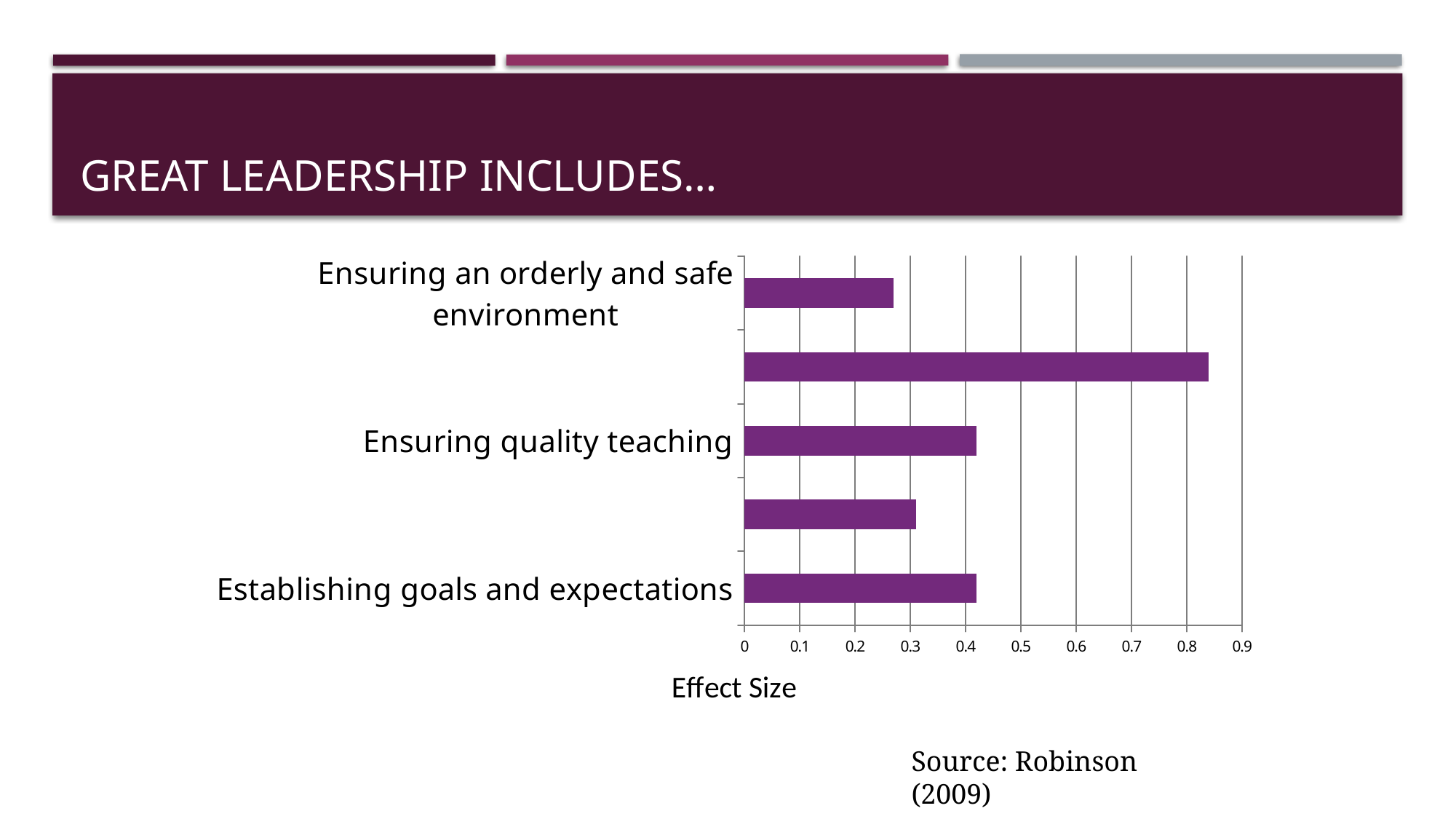
What is the title of the x axis of the chart? Effect Size What kind of chart is shown on the slide? bar chart How many bars are plotted in the chart? 5 Is the value for Establishing goals and expectations greater or less than 0.3? greater Which has the larger value: Ensuring quality teaching or Ensuring an orderly and safe environment? Ensuring quality teaching Is the value for Ensuring an orderly and safe environment greater or less than 0.4? less What is the highest value shown on the x axis of the chart? 0.9 Is the value of the longest bar in the chart greater or less than 0.8? greater Which has the larger value: Establishing goals and expectations or Ensuring an orderly and safe environment? Establishing goals and expectations